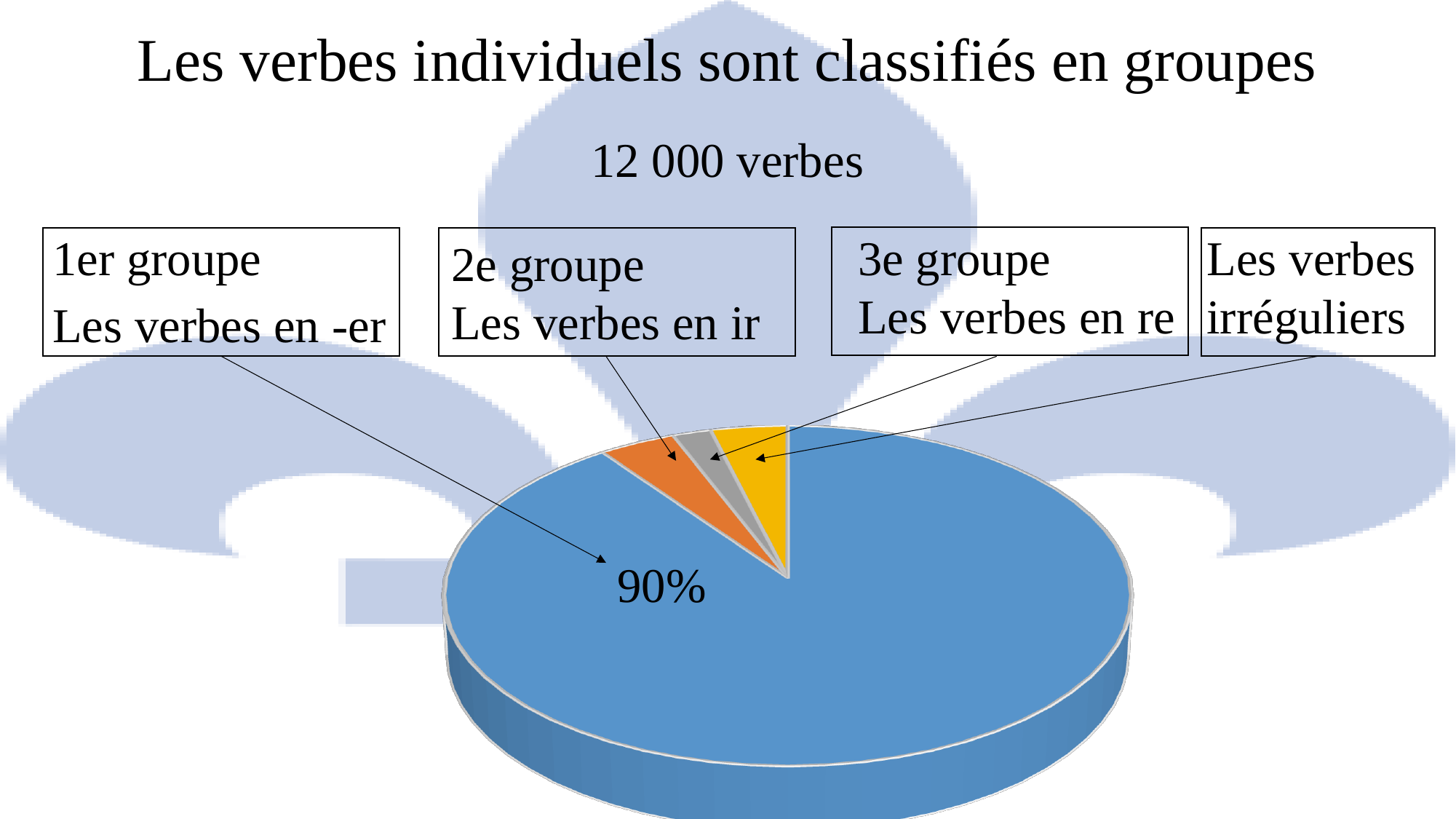
Which group has the smallest slice of the pie? 3e groupe (Les verbes en re) Which group has the largest slice of the pie? 1er groupe (Les verbes en -er) How many slices does the pie chart have? 4 Which slice is larger: 1er groupe or 2e groupe? 1er groupe What is the title of the slide containing the pie chart? Les verbes individuels sont classifiés en groupes What share of the pie does the 1er groupe (Les verbes en -er) slice represent? 90% What colour is the slice for the 1er groupe (Les verbes en -er)? blue Which slice is larger: 2e groupe (Les verbes en ir) or 3e groupe (Les verbes en re)? 2e groupe What kind of chart is shown on the slide? pie chart